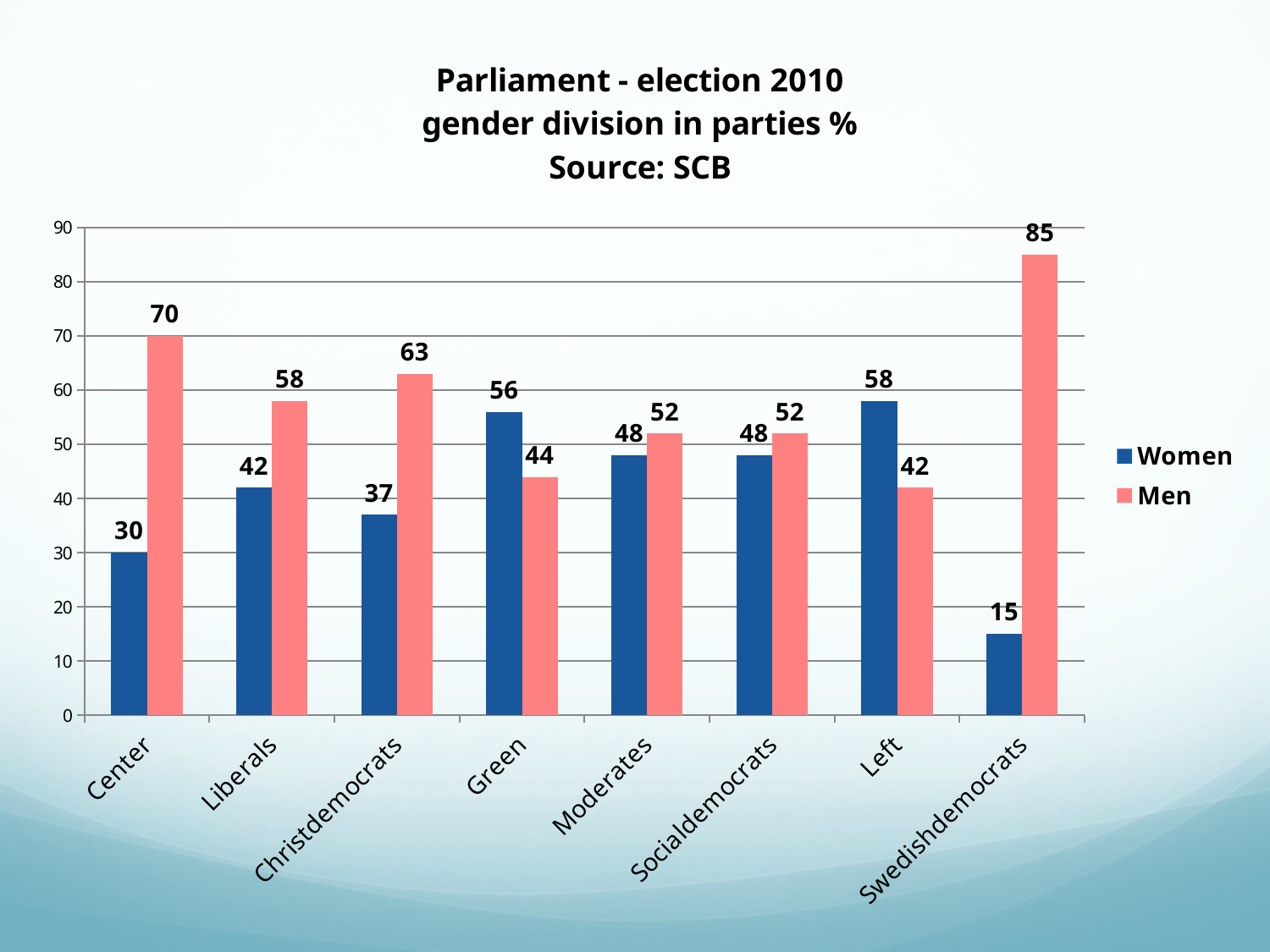
What is the value for Men in the Swedishdemocrats party? 85 What source is cited in the chart title? SCB Which party has the lowest value for Women? Swedishdemocrats What is the value for Women in the Center party? 30 What kind of chart is shown on the slide? Bar chart Which party has the highest value for Men? Swedishdemocrats What is the value for Women in the Green party? 56 How many parties are shown on the x axis? 8 Which is larger for the Left party, the Women value or the Men value? Women What is the difference between the Men and Women values for Christdemocrats? 26 What is the total of the Women and Men values for Moderates? 100 How many series does the legend list? 2